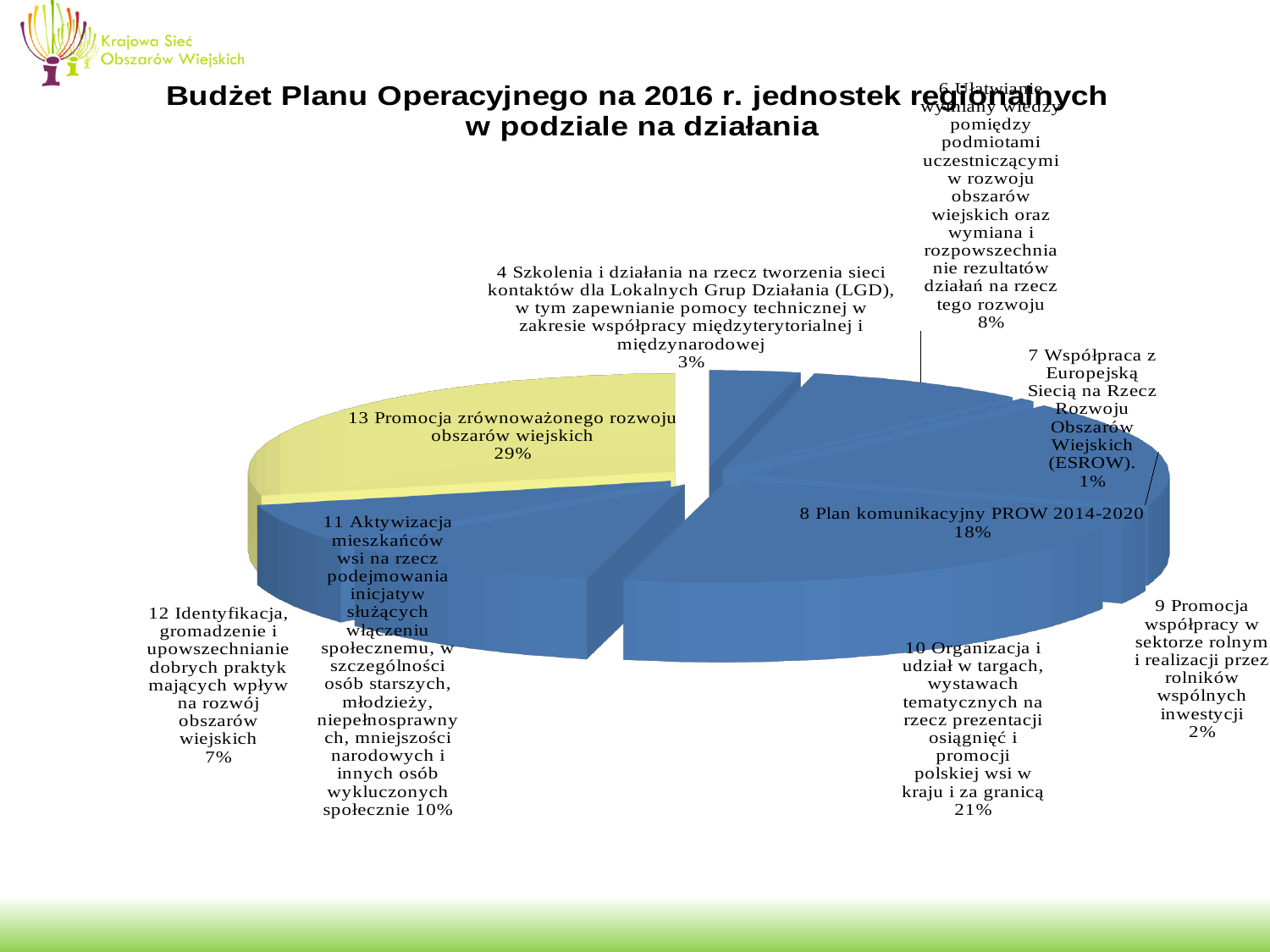
What is the title of the chart? Budżet Planu Operacyjnego na 2016 r. jednostek regionalnych w podziale na działania What colour is the slice for action 13 Promocja zrównoważonego rozwoju obszarów wiejskich? Yellow How many slices does the pie chart have? 9 What type of chart is shown on the slide? Pie chart What share of the budget is allocated to action 11 Aktywizacja mieszkańców wsi? 10% Which has a larger share: action 8 Plan komunikacyjny PROW 2014-2020 or action 6 Ułatwianie wymiany wiedzy? 8 Plan komunikacyjny PROW 2014-2020 What share of the budget is allocated to action 8 Plan komunikacyjny PROW 2014-2020? 18% What share of the budget is allocated to action 10 Organizacja i udział w targach, wystawach tematycznych? 21% What share of the budget is allocated to action 13 Promocja zrównoważonego rozwoju obszarów wiejskich? 29% Which action has the largest share of the budget? 13 Promocja zrównoważonego rozwoju obszarów wiejskich Which action has the smallest share of the budget? 7 Współpraca z Europejską Siecią na Rzecz Rozwoju Obszarów Wiejskich (ESROW). What is the difference in percentage points between action 13 (29%) and action 10 (21%)? 8